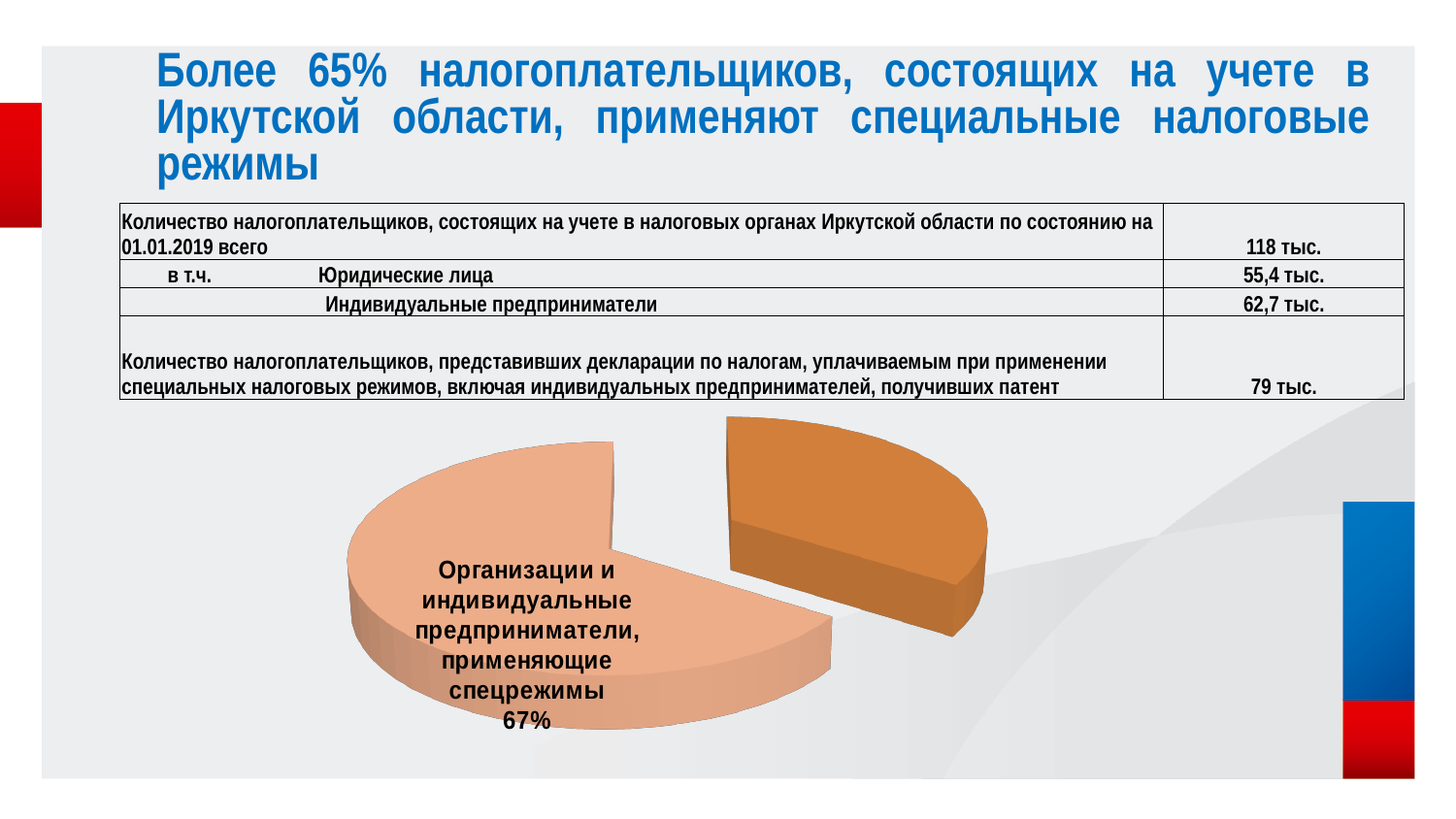
How many slices does the pie chart have? 2 Is the smaller slice of the pie pulled out (exploded) from the rest of the pie? yes Which slice of the pie chart is the largest? Организации и индивидуальные предприниматели, применяющие спецрежимы What share of the pie is labelled for organisations and individual entrepreneurs applying special tax regimes (Организации и индивидуальные предприниматели, применяющие спецрежимы)? 67% What colour is the larger slice of the pie chart? light orange (peach) What kind of chart is shown on the slide? pie chart Is the share of the slice for organisations and individual entrepreneurs applying special regimes greater or less than 50%? greater Which slice of the pie is larger: the labelled slice for those applying special regimes or the unlabelled slice? the labelled slice for those applying special regimes